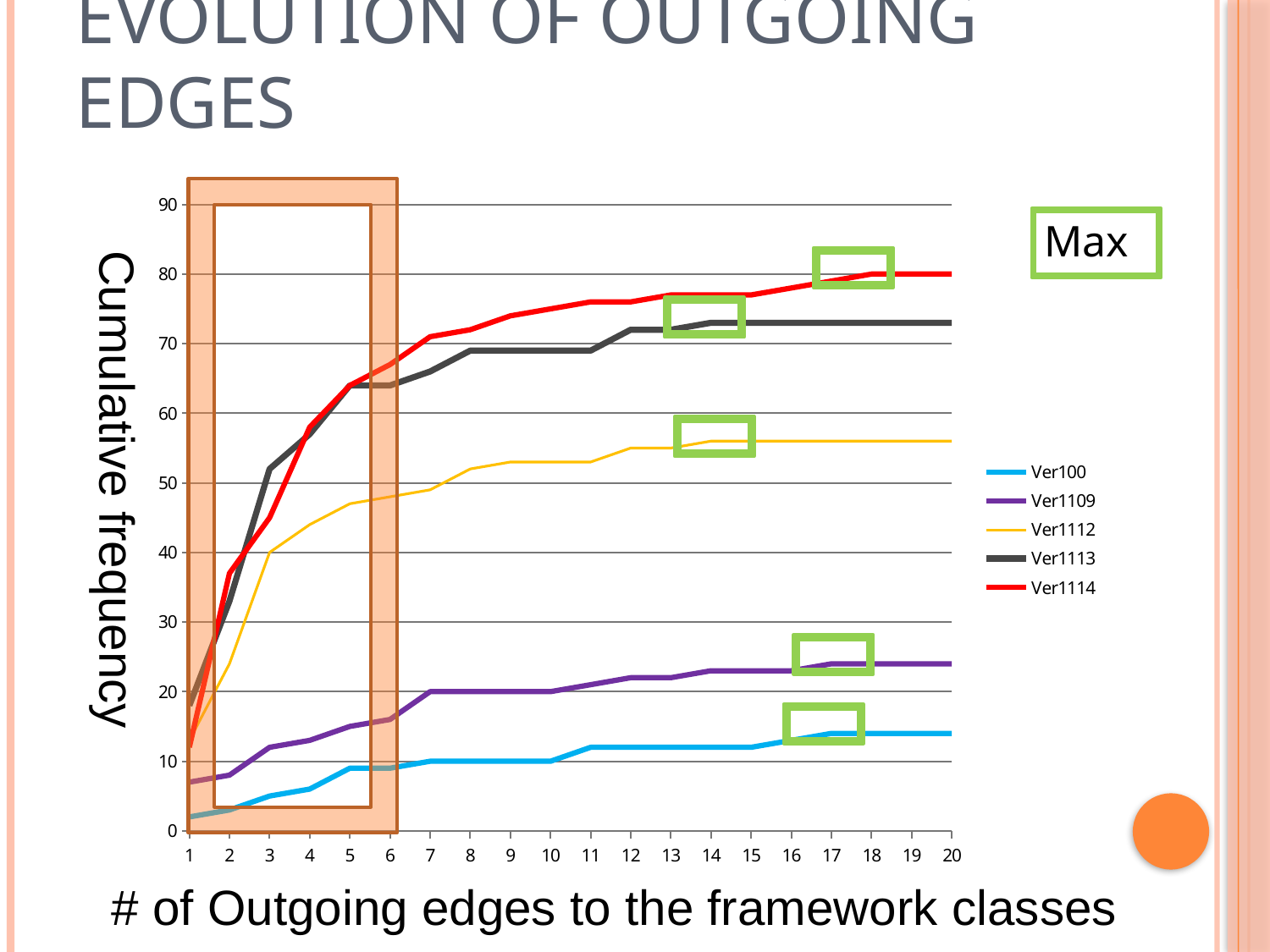
Is the value for Ver1113 at x = 20 greater or less than 70? greater Is the value for Ver100 at x = 20 greater or less than 10? greater How many points are on the x axis of the chart? 20 How many series does the legend list? 5 Is the value for Ver1112 at x = 20 greater or less than 60? less What is the title of the y axis? Cumulative frequency What is the cumulative frequency of Ver1114 at x = 20? 80 At x = 20, which series is larger, Ver1113 or Ver1112? Ver1113 Do the values of Ver1114 rise or fall as x increases from 1 to 20? rise Which series has the lowest cumulative frequency at x = 20? Ver100 Which series has the highest cumulative frequency at x = 20? Ver1114 What kind of chart is shown on the slide? line chart